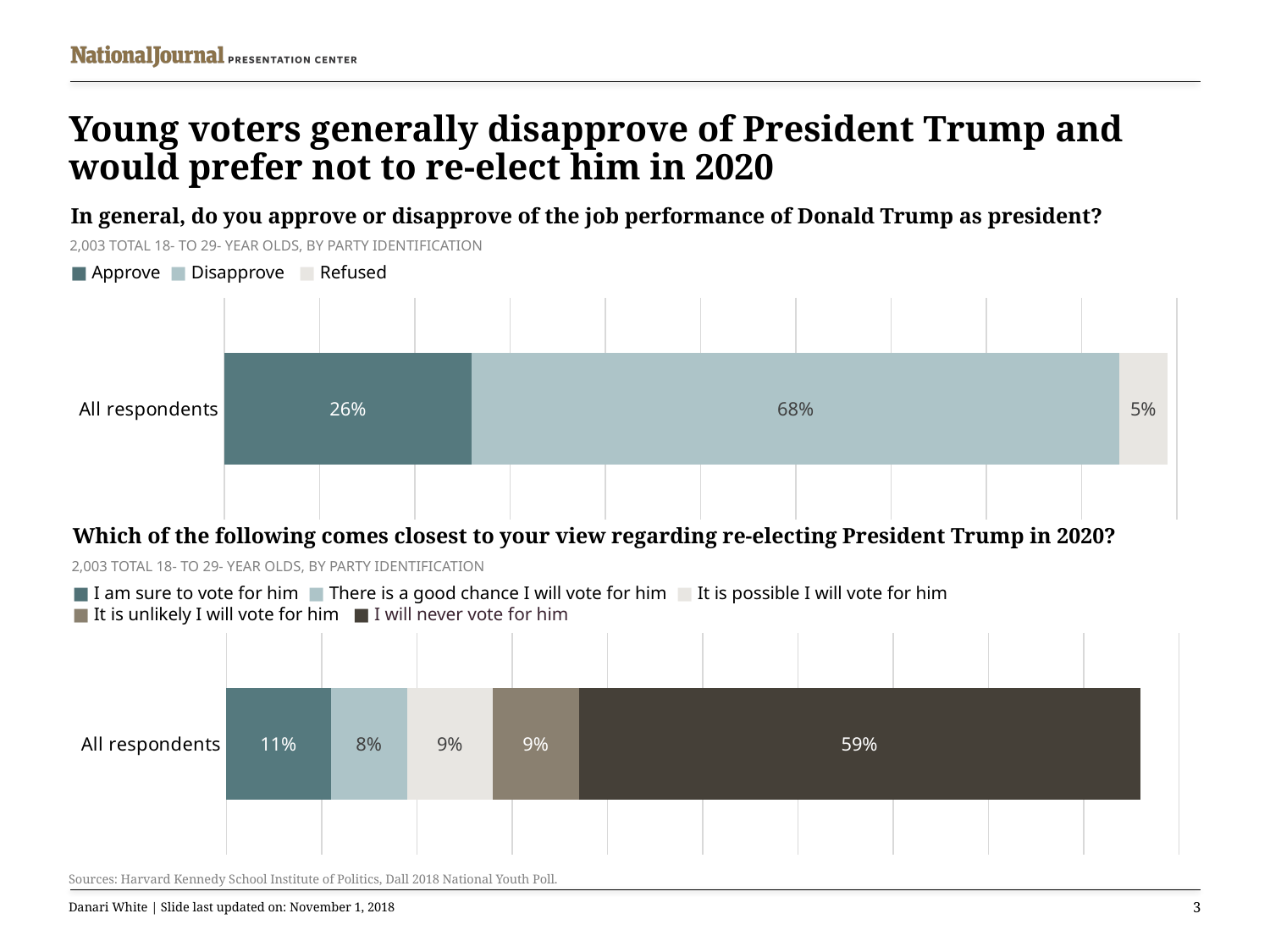
In the chart 'In general, do you approve or disapprove of the job performance of Donald Trump as president?', what percentage of all respondents disapprove? 68% In the chart 'Which of the following comes closest to your view regarding re-electing President Trump in 2020?', which is larger: 'I am sure to vote for him' or 'There is a good chance I will vote for him'? I am sure to vote for him In the chart 'In general, do you approve or disapprove of the job performance of Donald Trump as president?', what percentage of all respondents approve? 26% What kind of chart is used for the re-election question at the bottom of the slide? Stacked bar chart In the chart 'Which of the following comes closest to your view regarding re-electing President Trump in 2020?', what percentage of all respondents said 'I am sure to vote for him'? 11% In the chart 'In general, do you approve or disapprove of the job performance of Donald Trump as president?', what is the difference between the Disapprove and Approve percentages? 42 percentage points In the chart 'Which of the following comes closest to your view regarding re-electing President Trump in 2020?', what percentage of all respondents said 'I will never vote for him'? 59% In the chart 'In general, do you approve or disapprove of the job performance of Donald Trump as president?', what percentage of all respondents refused? 5% In the chart 'In general, do you approve or disapprove of the job performance of Donald Trump as president?', which response has the largest share? Disapprove In the chart 'Which of the following comes closest to your view regarding re-electing President Trump in 2020?', which response has the smallest share? There is a good chance I will vote for him In the chart 'In general, do you approve or disapprove of the job performance of Donald Trump as president?', how many series does the legend list? 3 In the chart 'Which of the following comes closest to your view regarding re-electing President Trump in 2020?', how many series does the legend list? 5